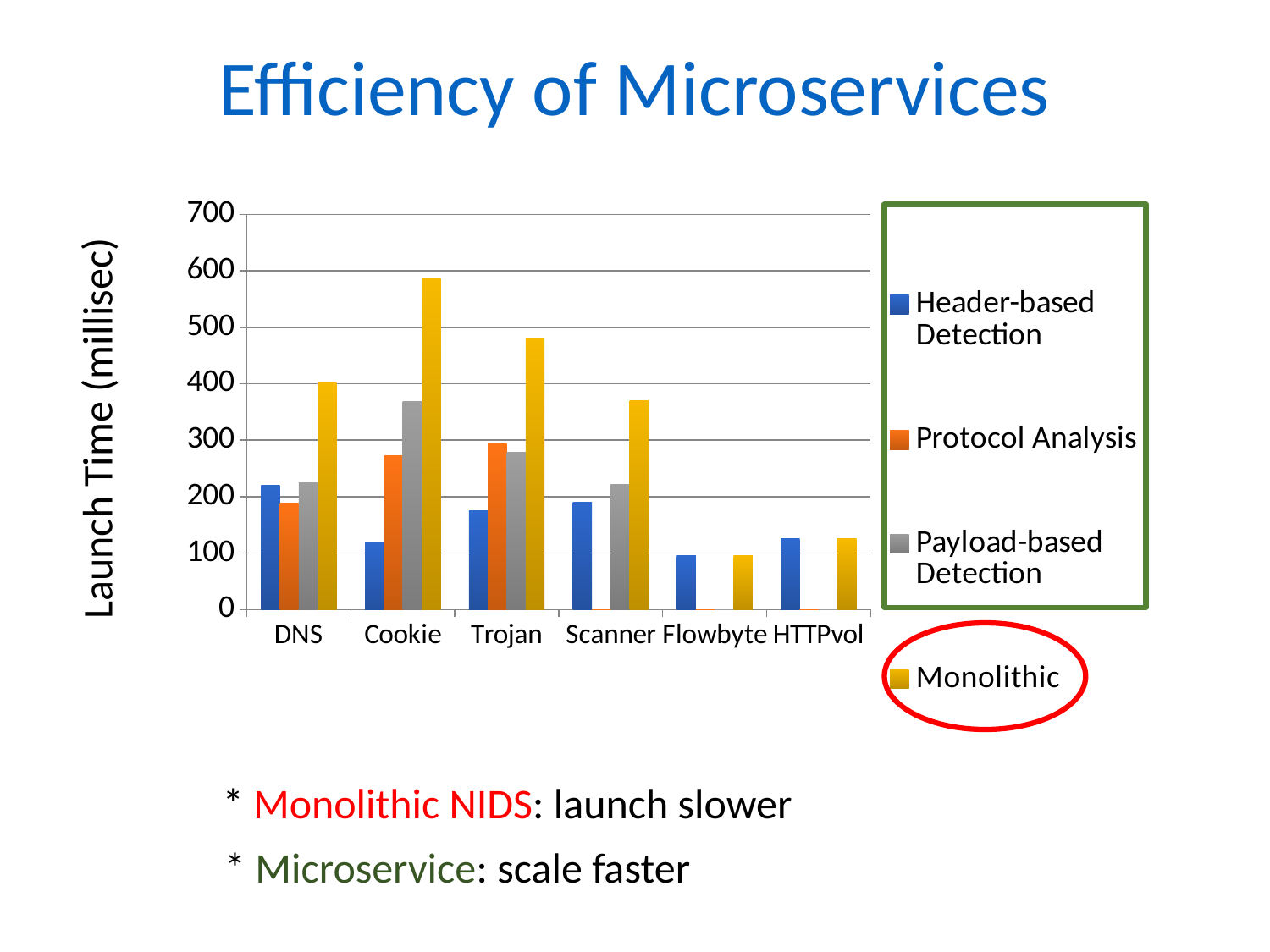
Is the Monolithic value for Trojan greater or less than 400? greater For which category is the Monolithic launch time highest? Cookie Which legend entry is circled in red on the slide? Monolithic What is the label of the vertical axis of the chart? Launch Time (millisec) How many categories are shown on the x axis of the chart? 6 Is the Header-based Detection value for HTTPvol greater or less than 100? greater How many series does the chart's legend list? 4 Is the Monolithic value for Cookie greater or less than 500? greater Which is larger, the Monolithic value for Cookie or the Monolithic value for Trojan? Cookie What kind of chart is shown on the slide? bar chart For which category is the Monolithic launch time lowest? Flowbyte